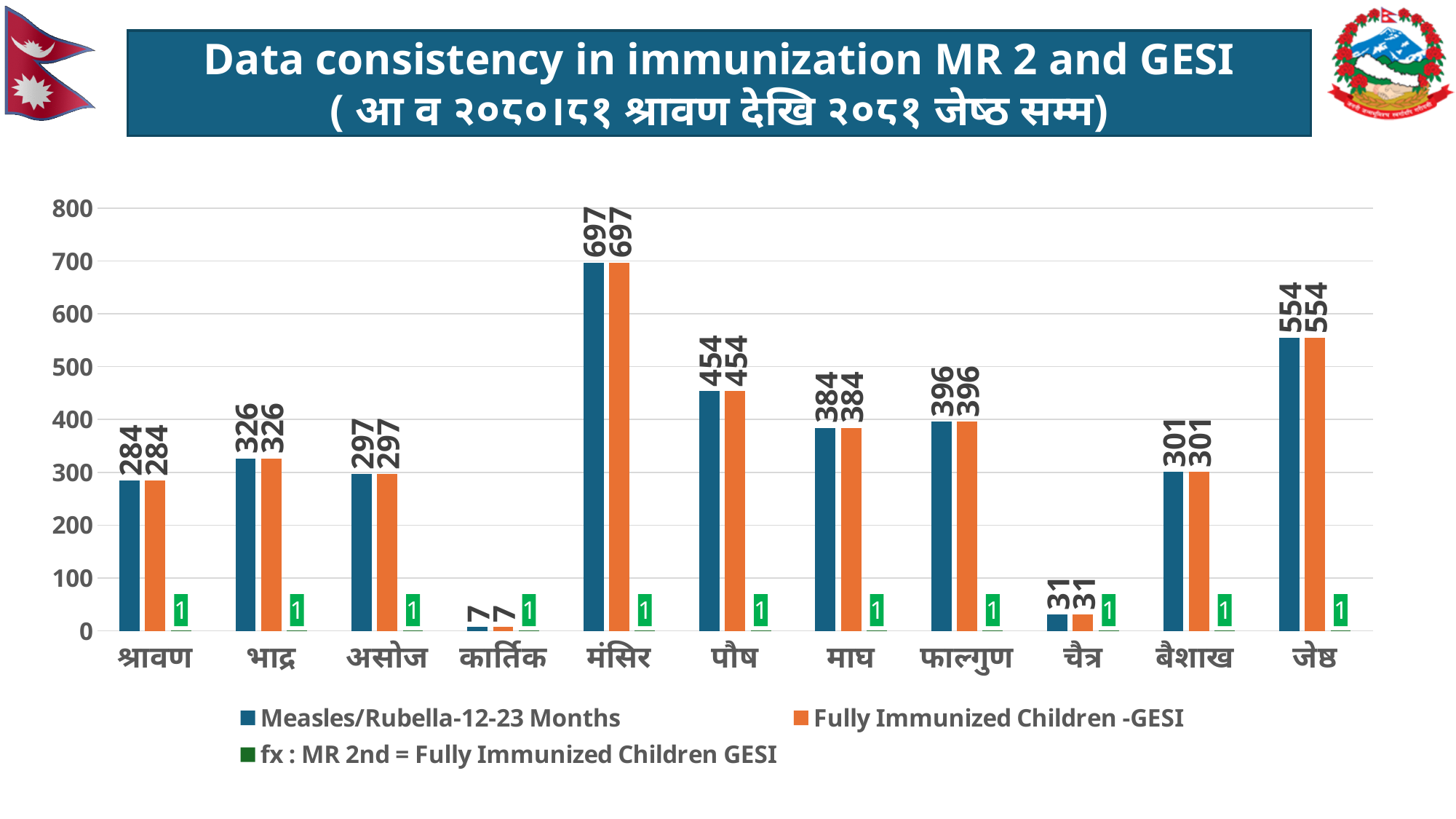
Which month has the highest Measles/Rubella-12-23 Months value? मंसिर How many month categories are shown on the x axis? 11 Which month has the lowest Fully Immunized Children -GESI value? कार्तिक What is the difference between the Measles/Rubella-12-23 Months values for मंसिर and जेष्ठ? 143 What value does the fx : MR 2nd = Fully Immunized Children GESI series show for each month? 1 What is the title of the chart on the slide? Data consistency in immunization MR 2 and GESI Which is larger, the Fully Immunized Children -GESI value for भाद्र or for असोज? भाद्र What is the Measles/Rubella-12-23 Months value for कार्तिक? 7 What is the Measles/Rubella-12-23 Months value for मंसिर? 697 What is the Fully Immunized Children -GESI value for जेष्ठ? 554 What type of chart is shown on the slide? bar chart How many series does the legend list? 3